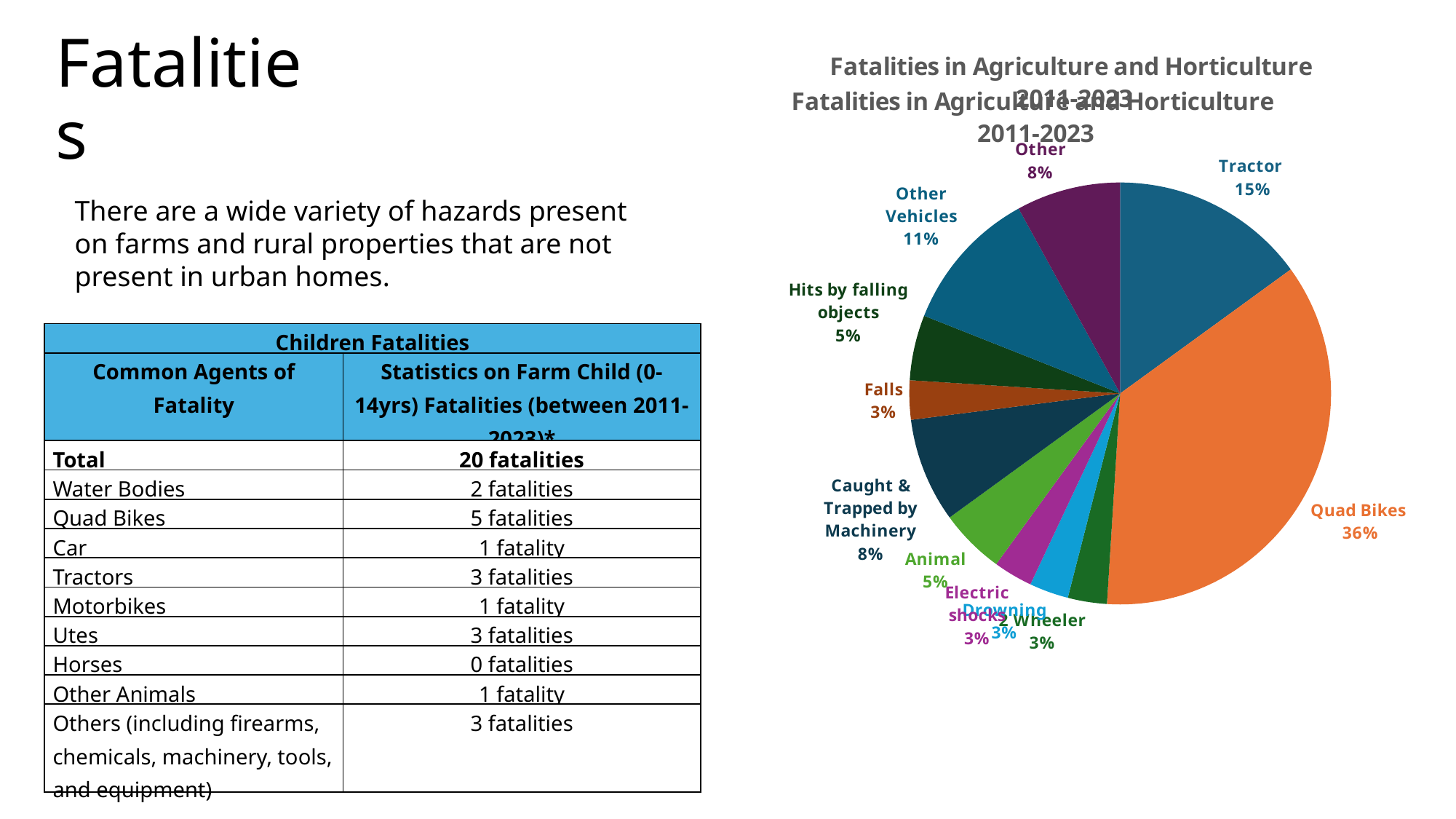
What kind of chart is shown on the slide? pie chart What is the value shown for Tractor in the pie chart? 15% What is the value shown for Other Vehicles in the pie chart? 11% What share of the pie does Quad Bikes account for? 36% What is the difference in percentage points between Other Vehicles and Animal? 6 Which is larger in the pie chart, Other Vehicles or Other? Other Vehicles What is the title of the pie chart? Fatalities in Agriculture and Horticulture 2011-2023 Which category has the largest slice of the pie chart? Quad Bikes How many slices does the pie chart have? 11 What is the difference in percentage points between Quad Bikes and Tractor? 21 What is the value shown for Hits by falling objects in the pie chart? 5% What is the value shown for Caught & Trapped by Machinery in the pie chart? 8%